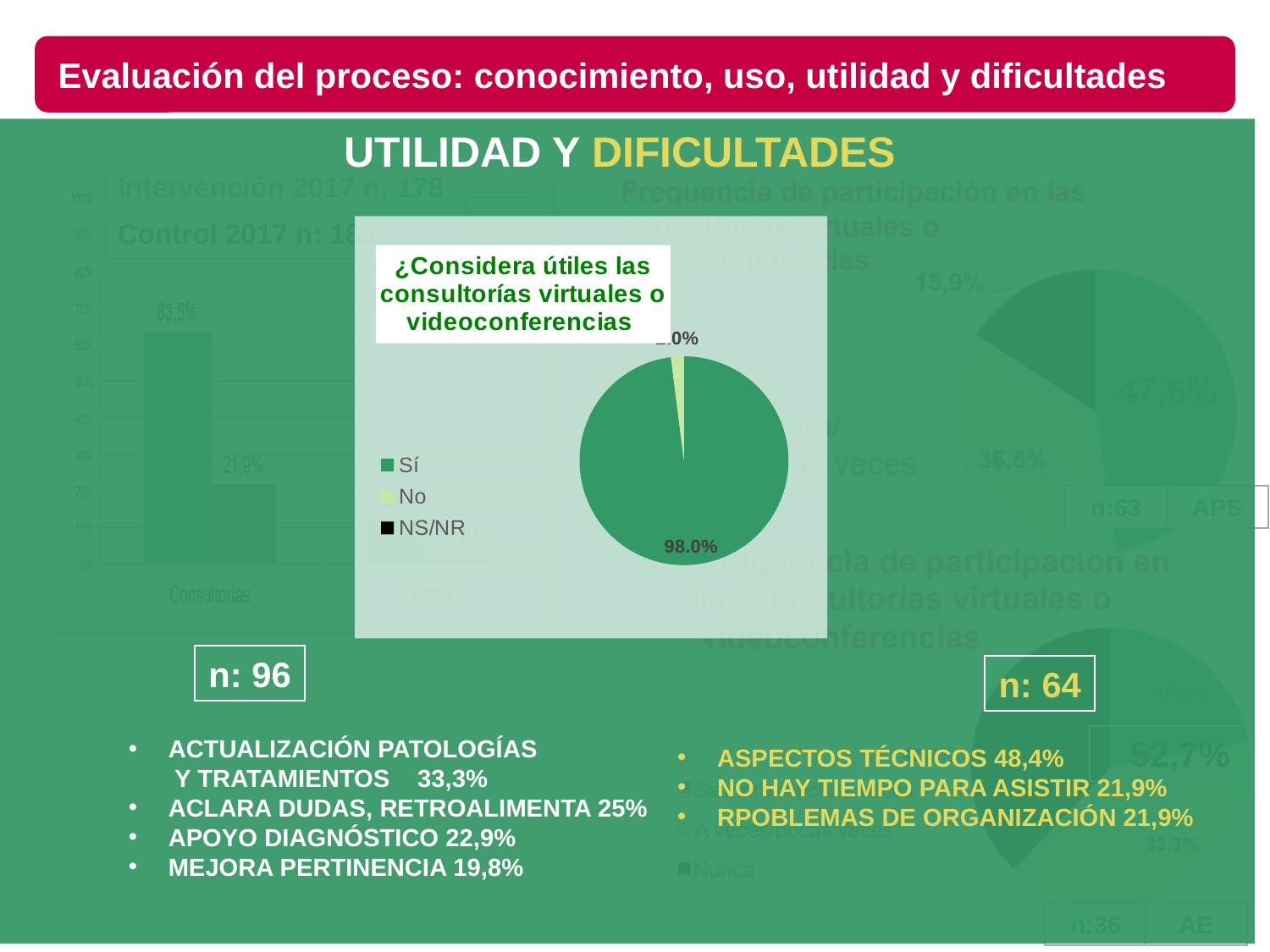
In the pie chart '¿Considera útiles las consultorías virtuales o videoconferencias', which slice is larger, 'Sí' or 'No'? Sí How many entries does the legend of the pie chart '¿Considera útiles las consultorías virtuales o videoconferencias' list? 3 In the pie chart '¿Considera útiles las consultorías virtuales o videoconferencias', what percentage is shown for 'Sí'? 98.0% In the pie chart '¿Considera útiles las consultorías virtuales o videoconferencias', which category has the largest slice? Sí What is the title of the pie chart in the centre of the slide? ¿Considera útiles las consultorías virtuales o videoconferencias What are the legend entries of the pie chart '¿Considera útiles las consultorías virtuales o videoconferencias'? Sí, No, NS/NR What share of the pie chart '¿Considera útiles las consultorías virtuales o videoconferencias' does 'Sí' represent? 98.0% What kind of chart is used for '¿Considera útiles las consultorías virtuales o videoconferencias'? Pie chart In the pie chart '¿Considera útiles las consultorías virtuales o videoconferencias', which slice is smaller, 'Sí' or 'No'? No